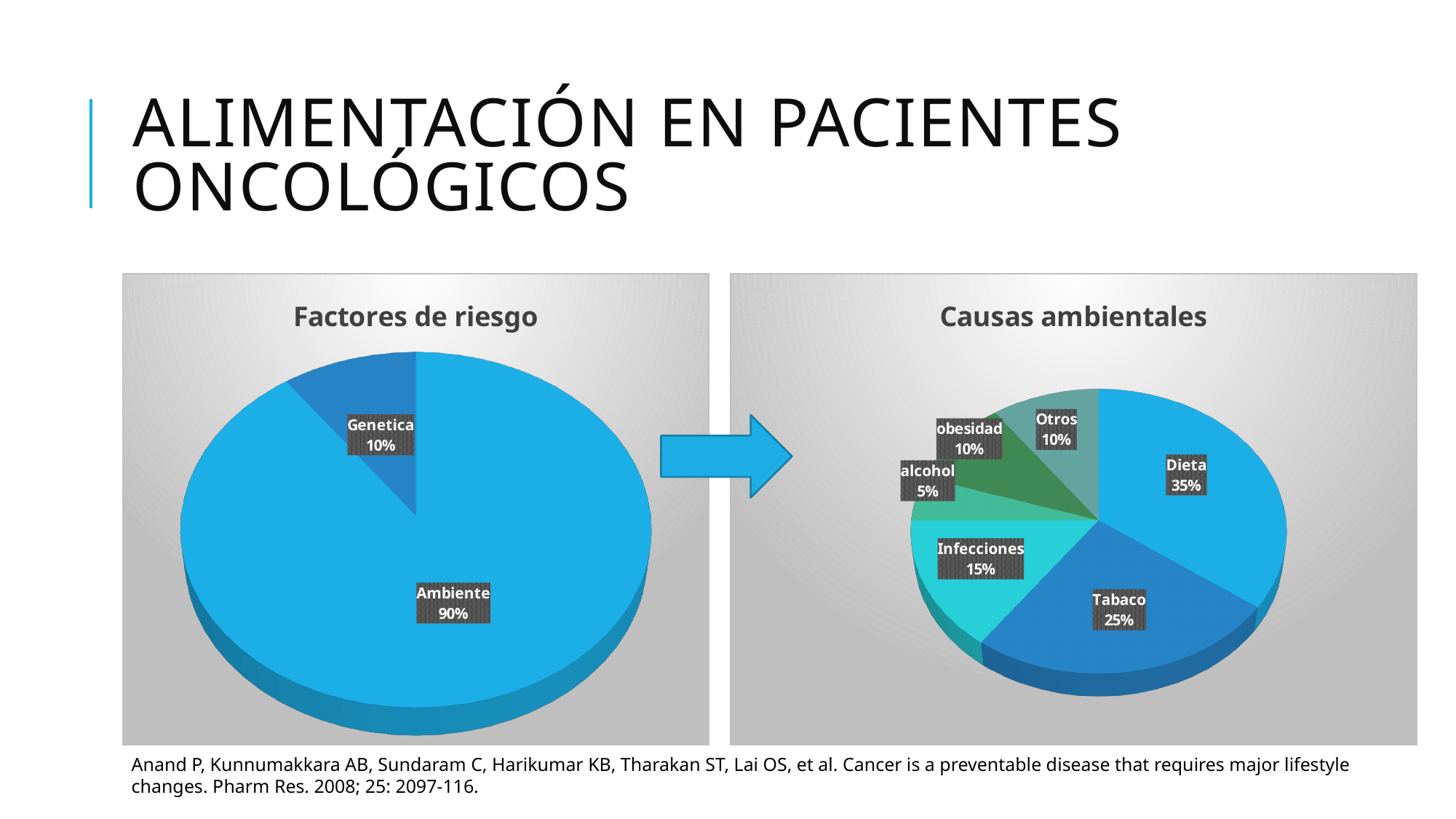
In the 'Factores de riesgo' chart, what is the difference between the Ambiente and Genetica percentages? 80% In the 'Factores de riesgo' chart, what percentage is shown for Ambiente? 90% In the 'Causas ambientales' chart, which category has the smallest share? alcohol In the 'Causas ambientales' chart, which is larger, Infecciones or obesidad? Infecciones In the 'Factores de riesgo' chart, what percentage is shown for Genetica? 10% In the 'Causas ambientales' chart, what percentage is shown for Tabaco? 25% What type of chart is the 'Factores de riesgo' chart? Pie chart In the 'Causas ambientales' chart, what percentage is shown for alcohol? 5% How many categories are shown in the 'Causas ambientales' chart? 6 In the 'Causas ambientales' chart, what is the difference between the Dieta and Tabaco percentages? 10% In the 'Causas ambientales' chart, which category has the largest share? Dieta In the 'Causas ambientales' chart, what percentage is shown for Dieta? 35%